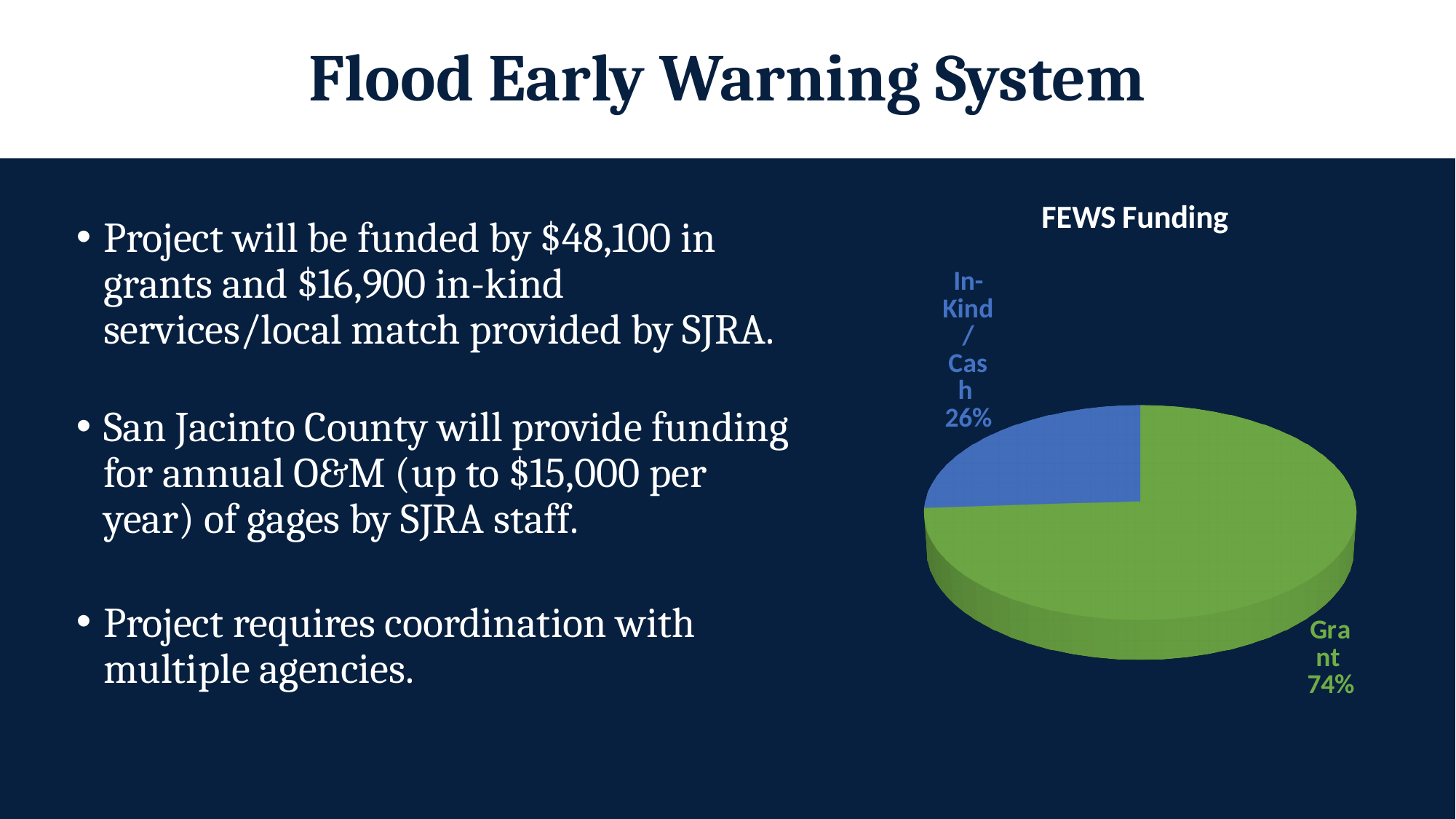
What is the difference in percentage points between the Grant and In-Kind/Cash slices? 48 Which slice of the FEWS Funding pie chart is the largest? Grant What is the title of the chart? FEWS Funding Which slice of the FEWS Funding pie chart is the smallest? In-Kind/Cash Is the Grant share of FEWS Funding greater or less than 50%? greater How many slices does the FEWS Funding pie chart have? 2 What kind of chart is shown on the slide? pie chart What colour is the Grant slice in the FEWS Funding pie chart? green Which is larger in the FEWS Funding chart, Grant or In-Kind/Cash? Grant What share of FEWS Funding does the In-Kind/Cash slice represent? 26% What share of FEWS Funding does the Grant slice represent? 74%